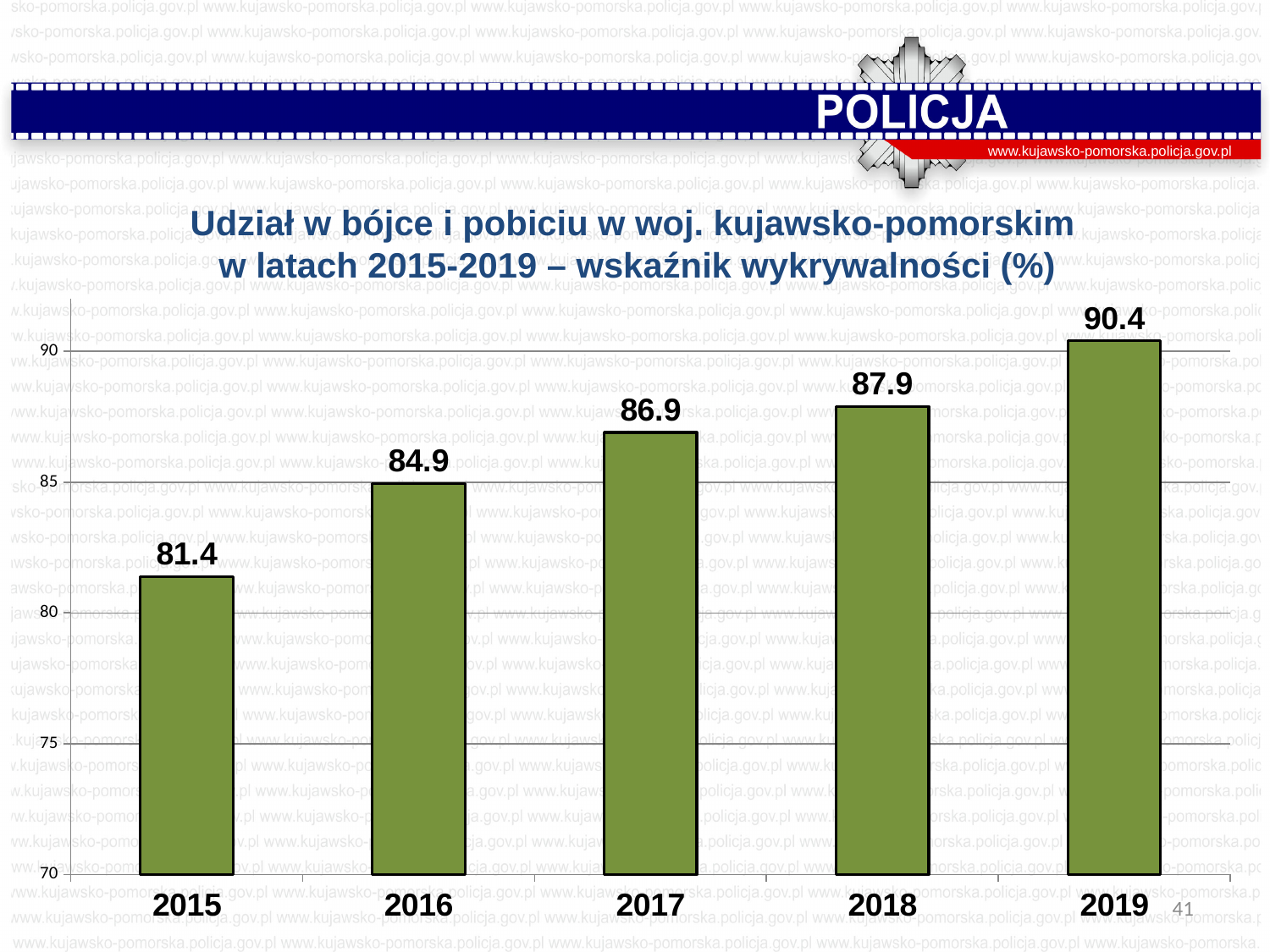
Which year has the highest value? 2019 How many years are shown on the x axis? 5 What kind of chart is shown on the slide? bar chart What is the difference between the values for 2019 and 2015? 9 Is the value for 2019 greater or less than 90? greater Do the values rise or fall from 2015 to 2019? rise Which is larger, the value for 2016 or the value for 2018? 2018 What is the difference between the values for 2018 and 2016? 3 What is the detection rate value shown for 2015? 81.4 What is the value shown for 2019? 90.4 What is the value shown for 2017? 86.9 Which year has the lowest value? 2015